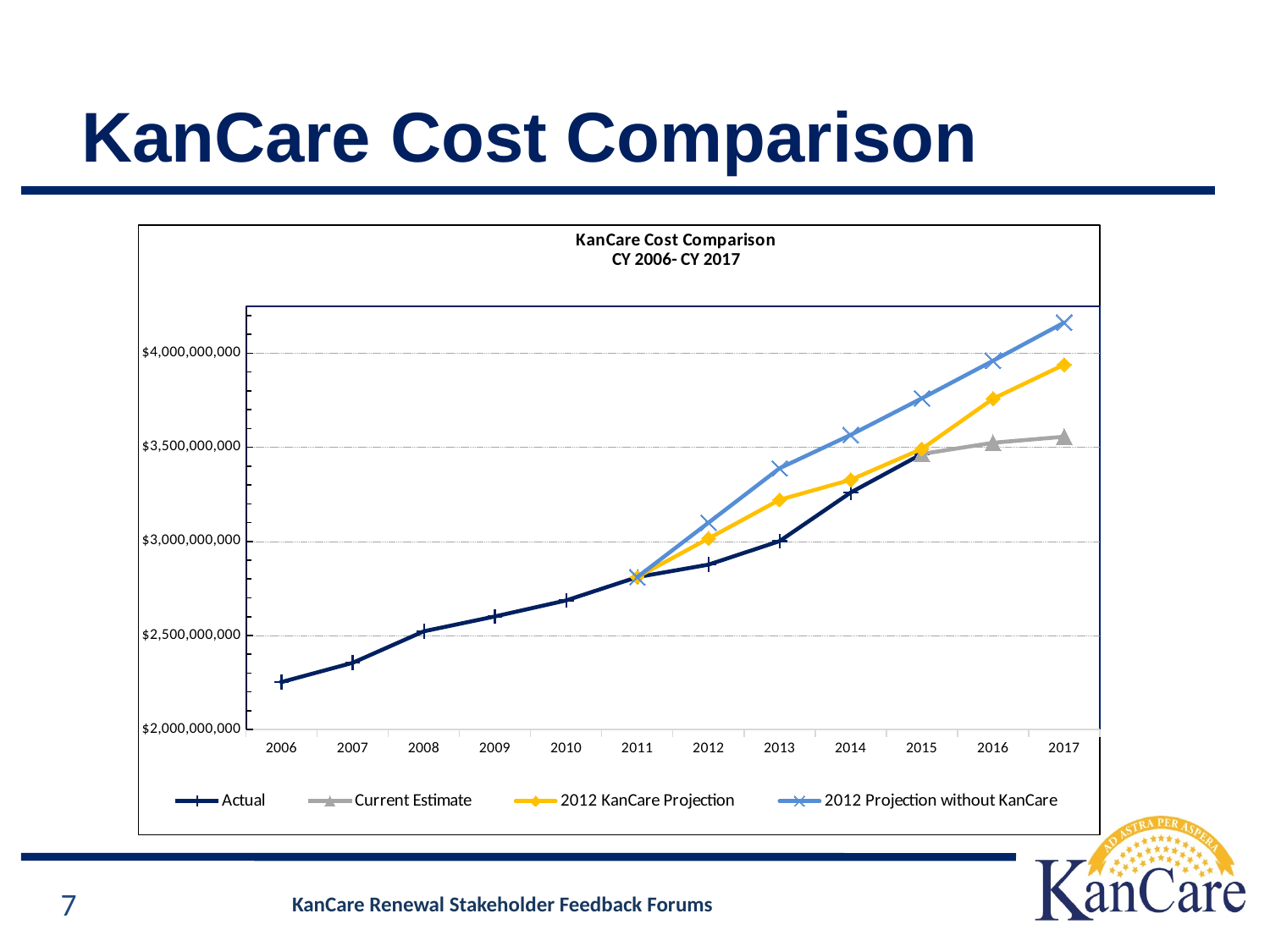
Does the Actual series rise or fall from 2006 to 2015? Rise Which series has the lowest value in 2017? Current Estimate Is the Actual value for 2006 greater or less than $2,500,000,000? less What kind of chart is shown on the slide? Line chart How many years are shown on the x axis? 12 In 2017, which is larger: the Current Estimate or the 2012 KanCare Projection? 2012 KanCare Projection Which series has the highest value in 2017? 2012 Projection without KanCare Is the 2012 Projection without KanCare value for 2017 greater or less than $4,000,000,000? greater Is the Actual value for 2014 greater or less than $3,500,000,000? less What is the title of the chart? KanCare Cost Comparison CY 2006- CY 2017 How many series does the legend list? 4